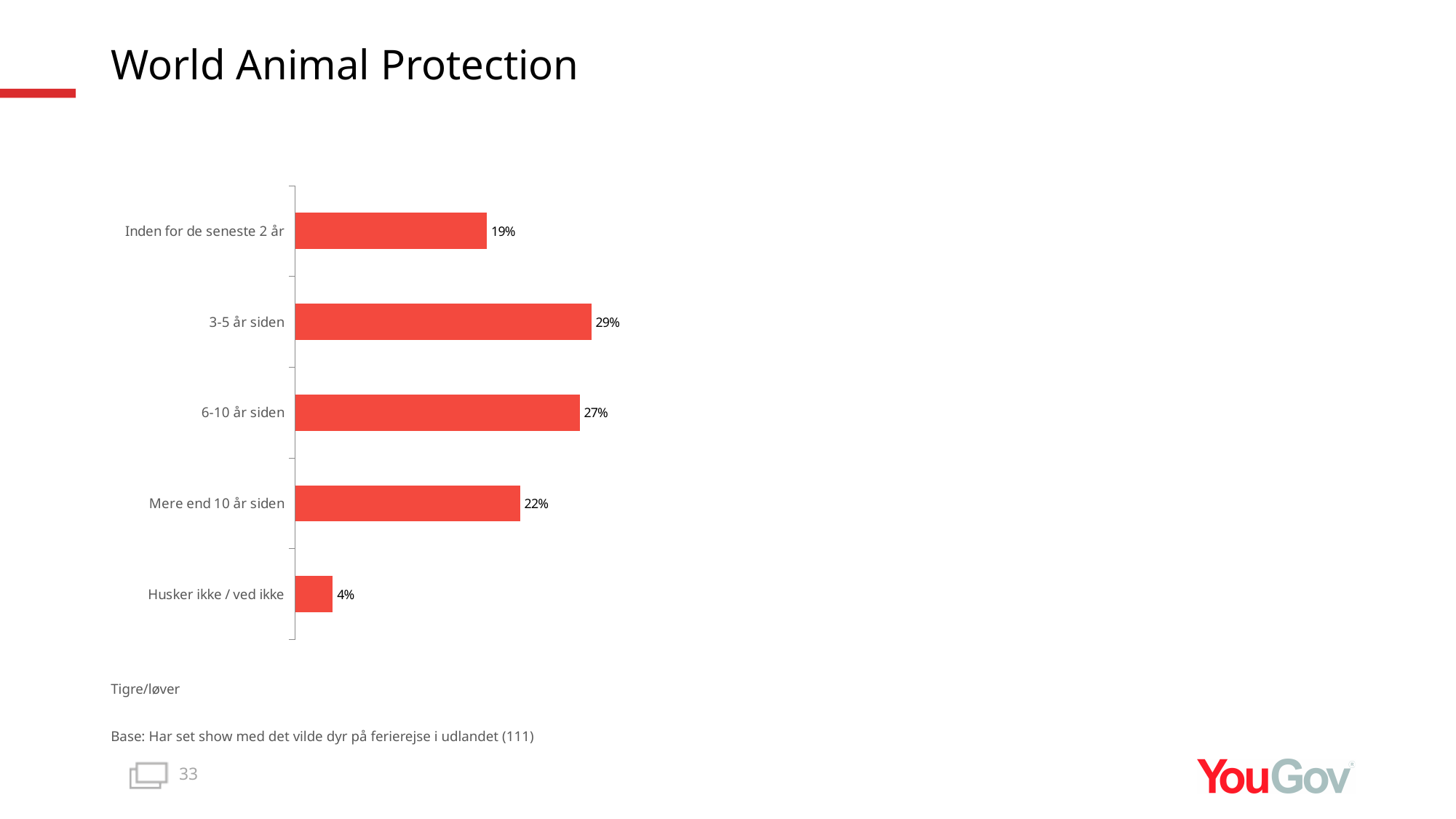
Which category has the highest value? 3-5 år siden What is the difference between the values for "3-5 år siden" and "6-10 år siden"? 2% What is the value for "Husker ikke / ved ikke"? 4% Which category has the lowest value? Husker ikke / ved ikke What is the value for "Inden for de seneste 2 år"? 19% What is the difference between the values for "Mere end 10 år siden" and "Husker ikke / ved ikke"? 18% What is the value for "3-5 år siden"? 29% What label appears below the chart indicating the animal type? Tigre/løver Which is larger: the value for "Inden for de seneste 2 år" or "Mere end 10 år siden"? Mere end 10 år siden What kind of chart is shown on the slide? Bar chart How many categories are shown in the chart? 5 What is the value for "Mere end 10 år siden"? 22%